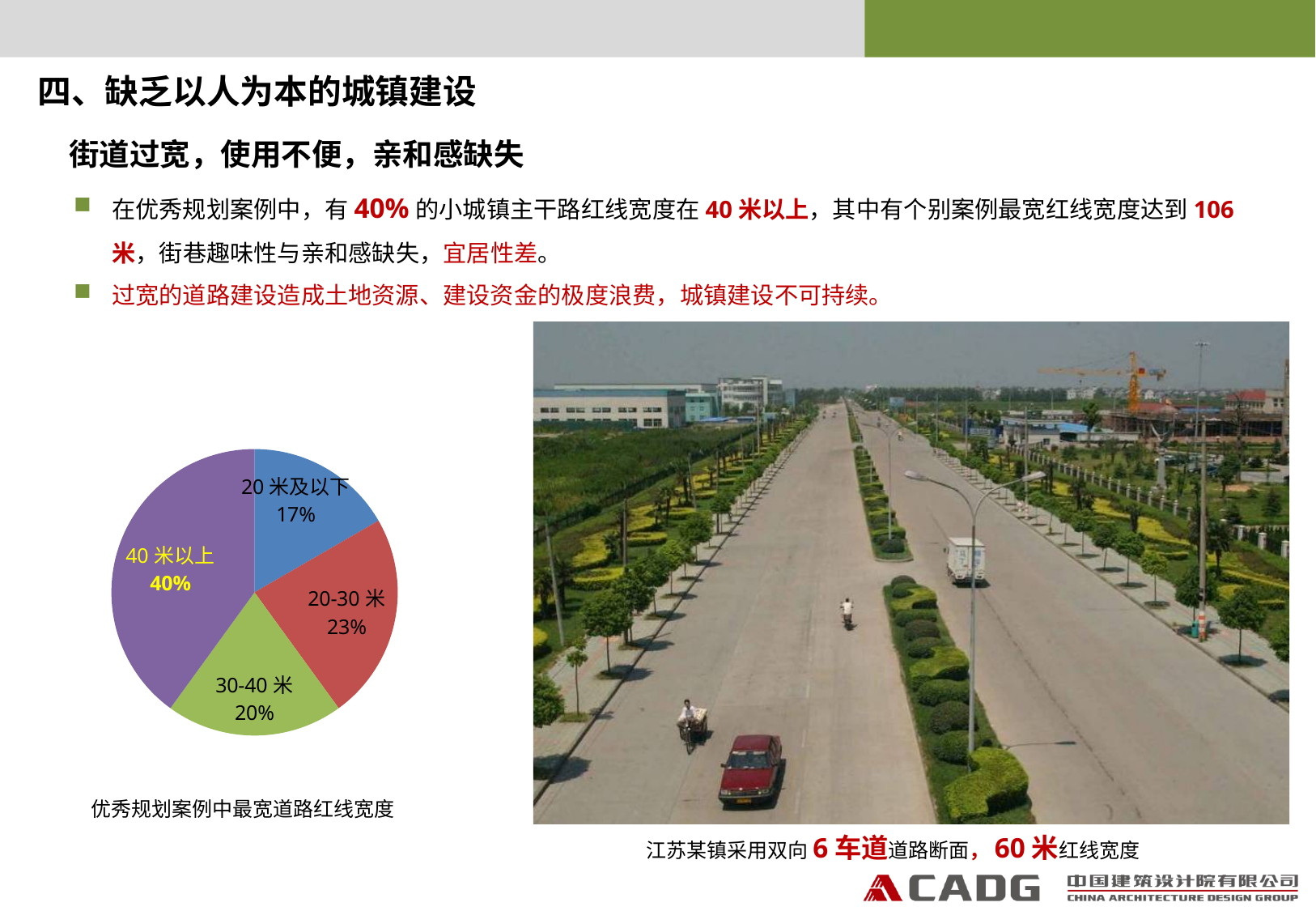
What is the combined share of the 20 米及以下 and 20-30 米 slices? 40% What is the difference between the 40 米以上 share and the 20-30 米 share? 17% What is the value shown for the 20-30 米 slice? 23% What kind of chart is shown on the slide? pie chart What is the value shown for the 30-40 米 slice? 20% Which is larger, the 20-30 米 slice or the 30-40 米 slice? 20-30 米 What share of the pie does the 40 米以上 slice represent? 40% What is the value shown for the 20 米及以下 slice? 17% What colour is the 40 米以上 slice of the pie chart? purple Which category has the smallest slice of the pie? 20 米及以下 Which category has the largest slice of the pie? 40 米以上 How many slices does the pie chart have? 4